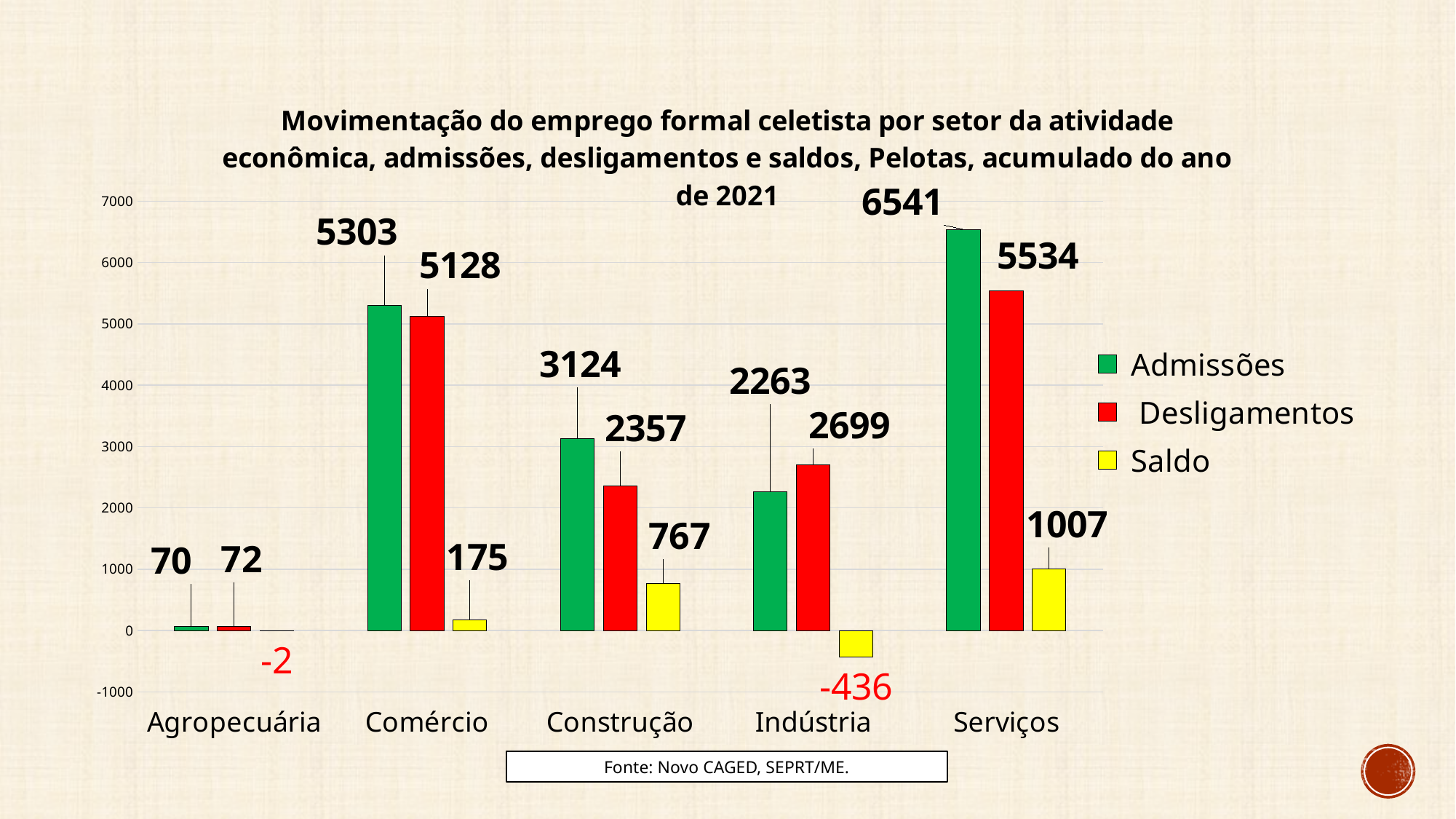
How many sectors are shown on the x axis? 5 Which sector has the lowest Saldo value? Indústria Which sector has the highest Admissões value? Serviços What kind of chart is shown on the slide? Bar chart How many series does the legend list? 3 What is the difference between Admissões and Desligamentos for Construção? 767 Which is larger for Indústria, Admissões or Desligamentos? Desligamentos What is the Saldo value for Indústria? -436 What is the value of Admissões for Comércio? 5303 Which colour represents the Saldo series? Yellow What is the Saldo value for Serviços? 1007 What is the value of Desligamentos for Indústria? 2699